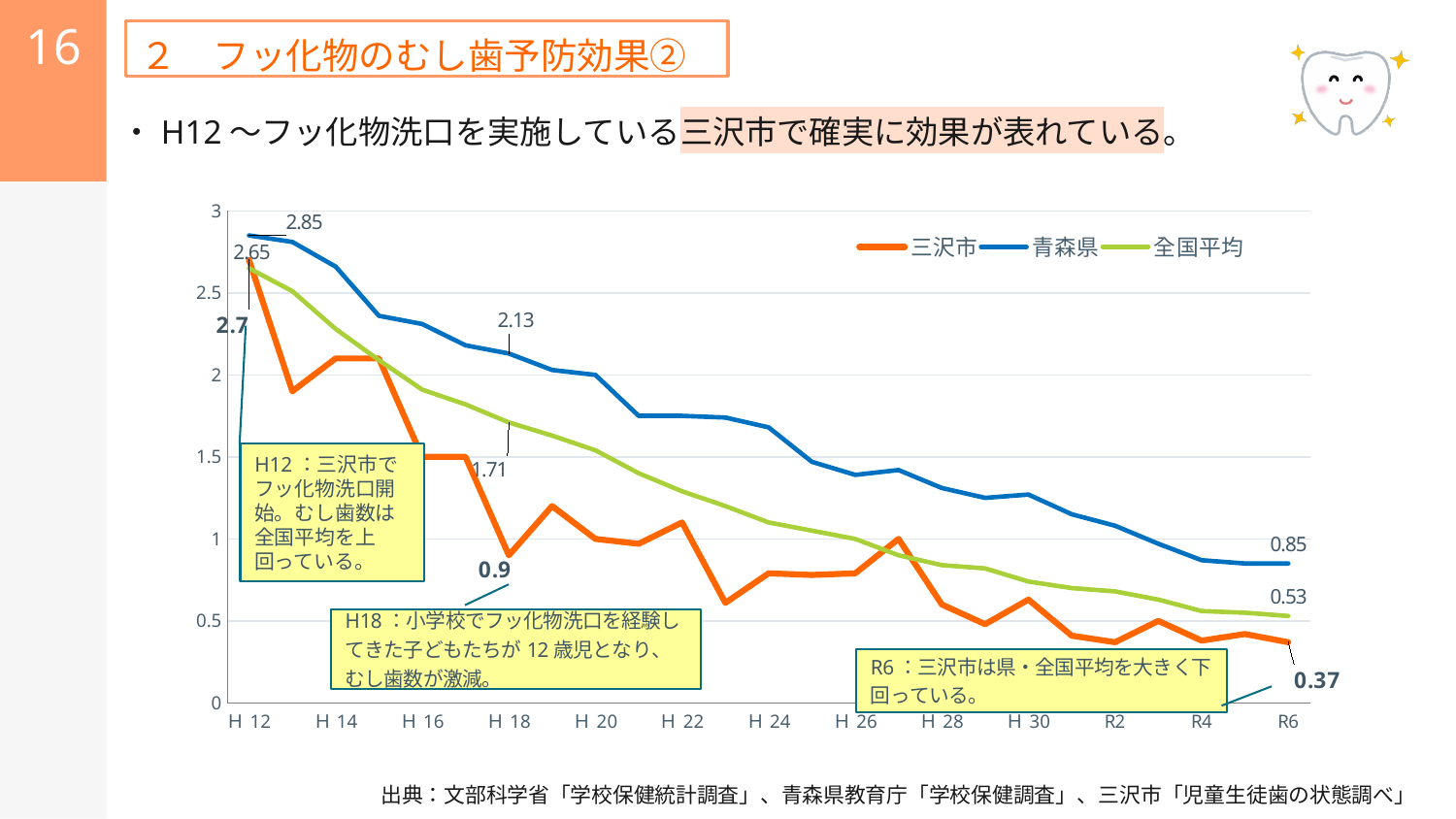
What is the value for 三沢市 at H18? 0.9 How many series does the legend list? 3 What is the value for 三沢市 at H12? 2.7 Is the value for 青森県 at H22 greater or less than 1.5? greater Which series has the lowest value at R6? 三沢市 At R6, which is larger: 青森県 or 全国平均? 青森県 What is the value for 三沢市 at R6? 0.37 What kind of chart is shown on the slide? line chart What is the value for 全国平均 at R6? 0.53 What is the value for 全国平均 at H18? 1.71 What is the value for 青森県 at R6? 0.85 What is the difference between 青森県 and 三沢市 at R6? 0.48